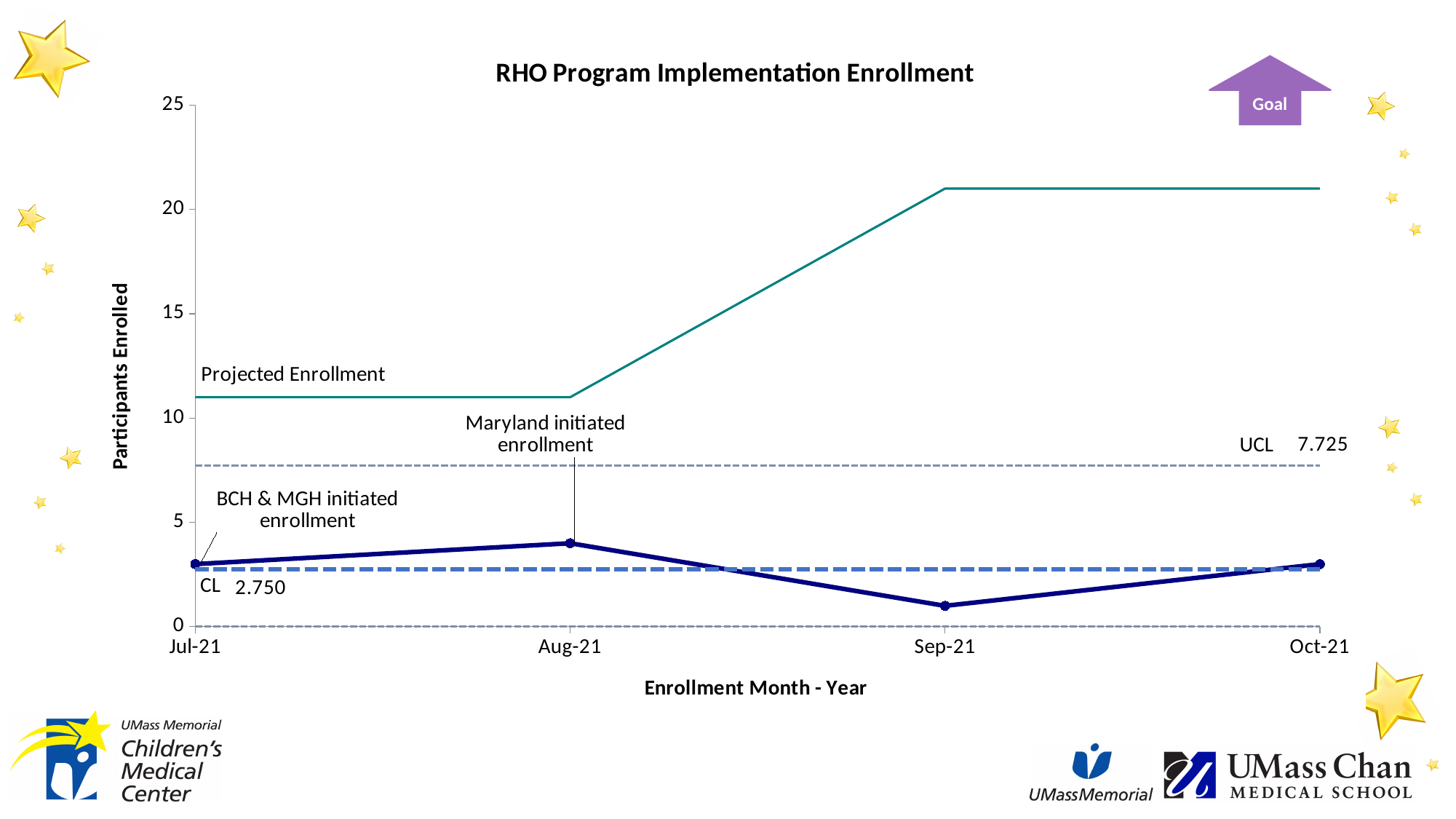
In which month is the actual enrollment (dark blue line) highest? Aug-21 Is the Projected Enrollment value for Oct-21 greater or less than 20? greater Is the actual enrollment value for Sep-21 greater or less than 5? less What is the title of the chart? RHO Program Implementation Enrollment Which is larger, the actual enrollment in Aug-21 or in Sep-21? Aug-21 What is the value of the CL line on the chart? 2.750 What kind of chart is shown on the slide? line chart Does the Projected Enrollment line rise or fall from Aug-21 to Sep-21? rise What is the value of the UCL line on the chart? 7.725 In which month is the actual enrollment (dark blue line) lowest? Sep-21 How many months are shown on the x axis of the chart? 4 What is the difference between the UCL value and the CL value? 4.975